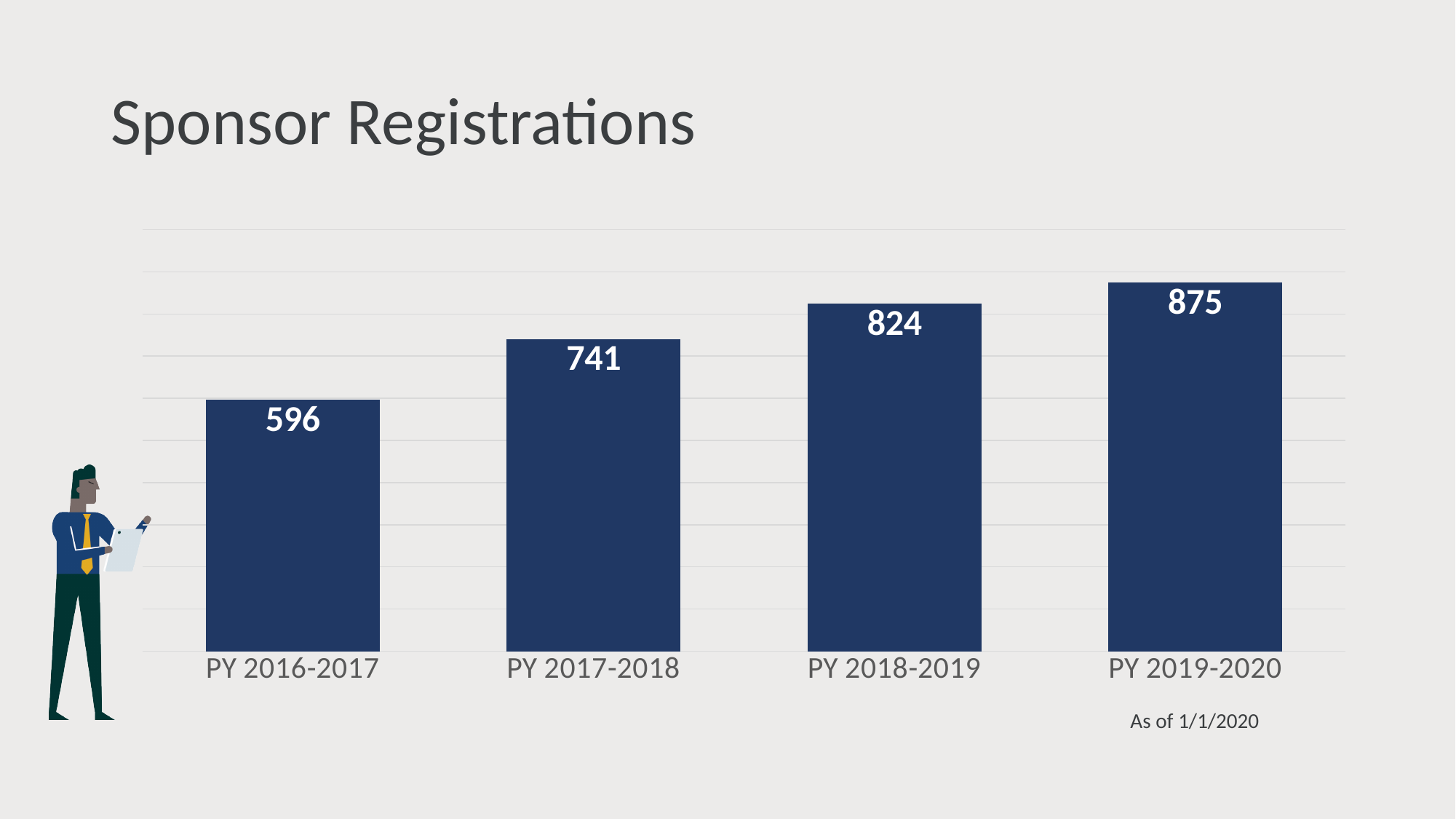
Do the values rise or fall from PY 2016-2017 to PY 2019-2020? Rise What is the value for PY 2019-2020? 875 Which program year has the highest number of sponsor registrations? PY 2019-2020 What is the value for PY 2018-2019? 824 How many program years are shown in the chart? 4 What is the difference between the values for PY 2017-2018 and PY 2016-2017? 145 What kind of chart is shown on the slide? Bar chart What is the value for PY 2016-2017? 596 Which is larger, the value for PY 2017-2018 or PY 2018-2019? PY 2018-2019 What is the difference between the values for PY 2019-2020 and PY 2016-2017? 279 What is the value for PY 2017-2018? 741 Which program year has the lowest number of sponsor registrations? PY 2016-2017